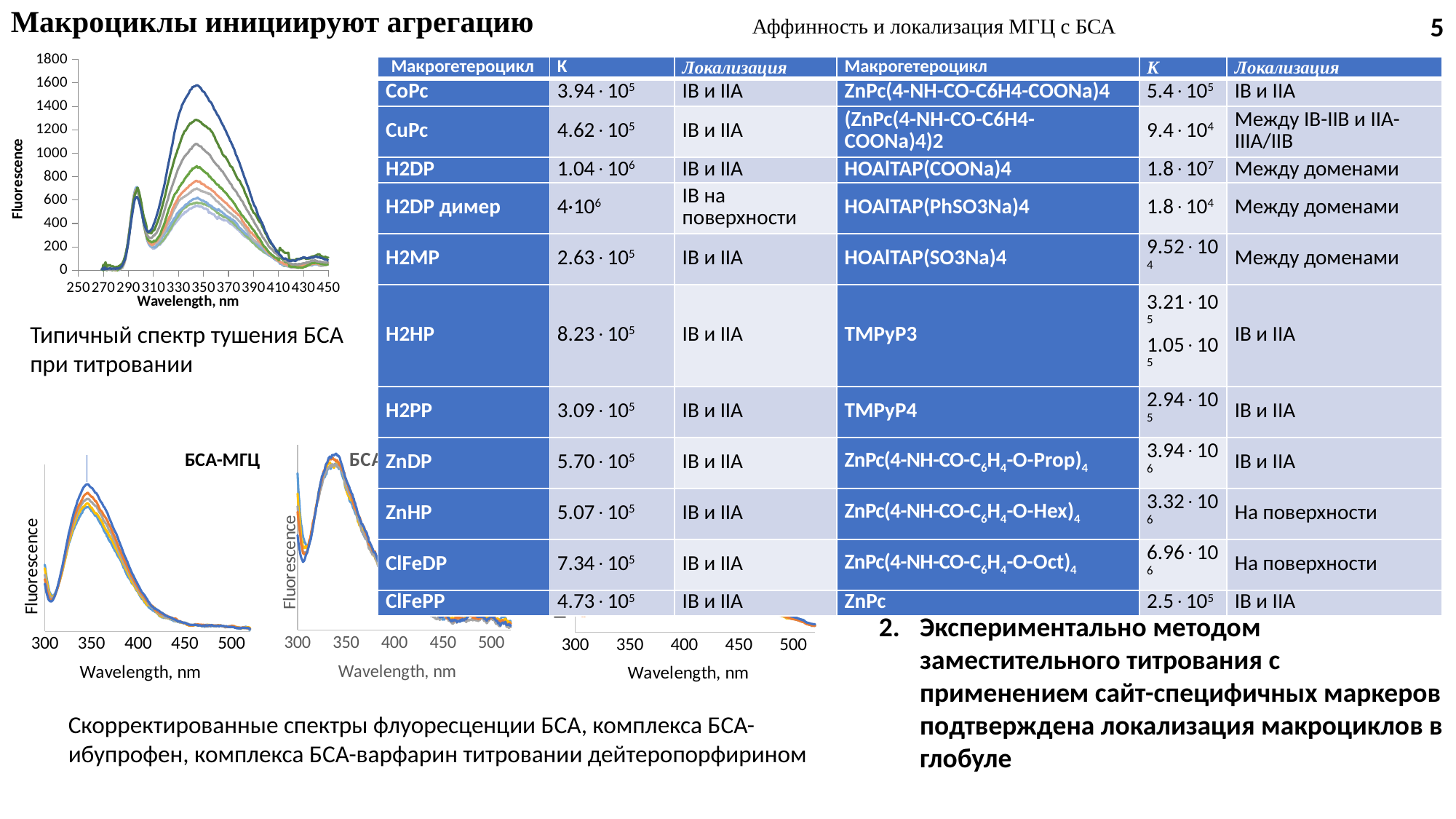
In the top-left chart, do the curves rise or fall between 350 nm and 410 nm? fall In the top-left chart, is the peak value of the lowest curve greater or less than 800? less In the top-left chart, is the value of the curves at 450 nm greater or less than 200? less In the top-left chart, is the peak value of the highest curve greater or less than 1400? greater In the bottom-left chart titled БСА-МГЦ, do the curves rise or fall between 350 nm and 500 nm? fall What is the title of the bottom-left chart? БСА-МГЦ In the top-left chart, what is the highest value shown on the y axis? 1800 What kind of chart is the bottom-left chart titled БСА-МГЦ? line chart What kind of chart is the top-left chart with the y axis labelled Fluorescence? line chart In the top-left chart, do the curves rise or fall between 310 nm and 340 nm? rise In the top-left chart, what is the label of the x axis? Wavelength, nm